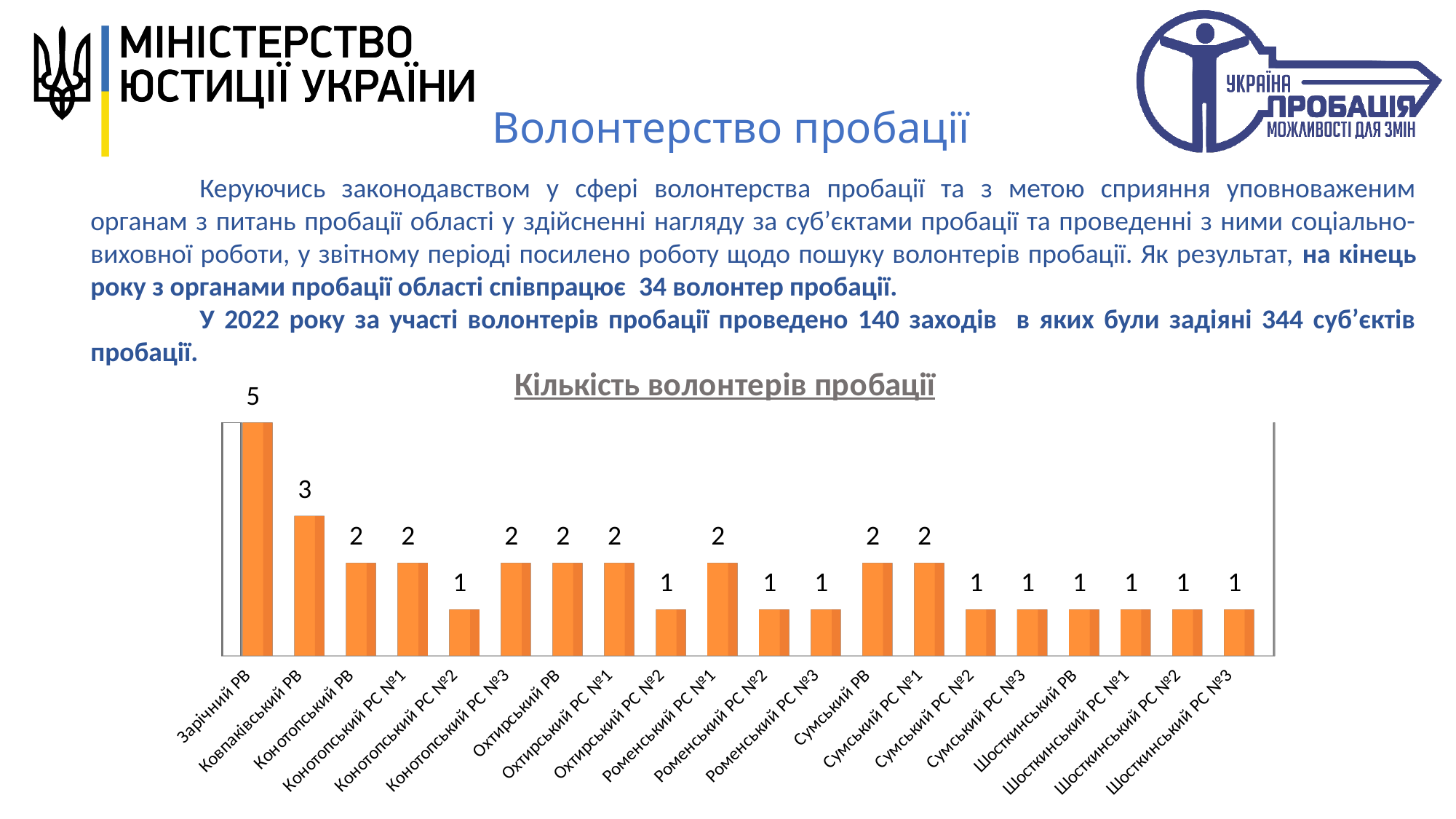
What is the difference between the values for Зарічний РВ and Ковпаківський РВ? 2 What is the difference between the values for Ковпаківський РВ and Шосткинський РВ? 2 What is the value for Ковпаківський РВ? 3 What is the title of the chart? Кількість волонтерів пробації What kind of chart is shown on the slide? bar chart What is the value for Конотопський РС №2? 1 What is the value for Сумський РВ? 2 Which category has the highest value in the chart? Зарічний РВ Which is larger, the value for Охтирський РВ or the value for Охтирський РС №2? Охтирський РВ What is the value for Зарічний РВ in the chart 'Кількість волонтерів пробації'? 5 How many categories are shown in the chart? 20 What colour are the bars in the chart? orange